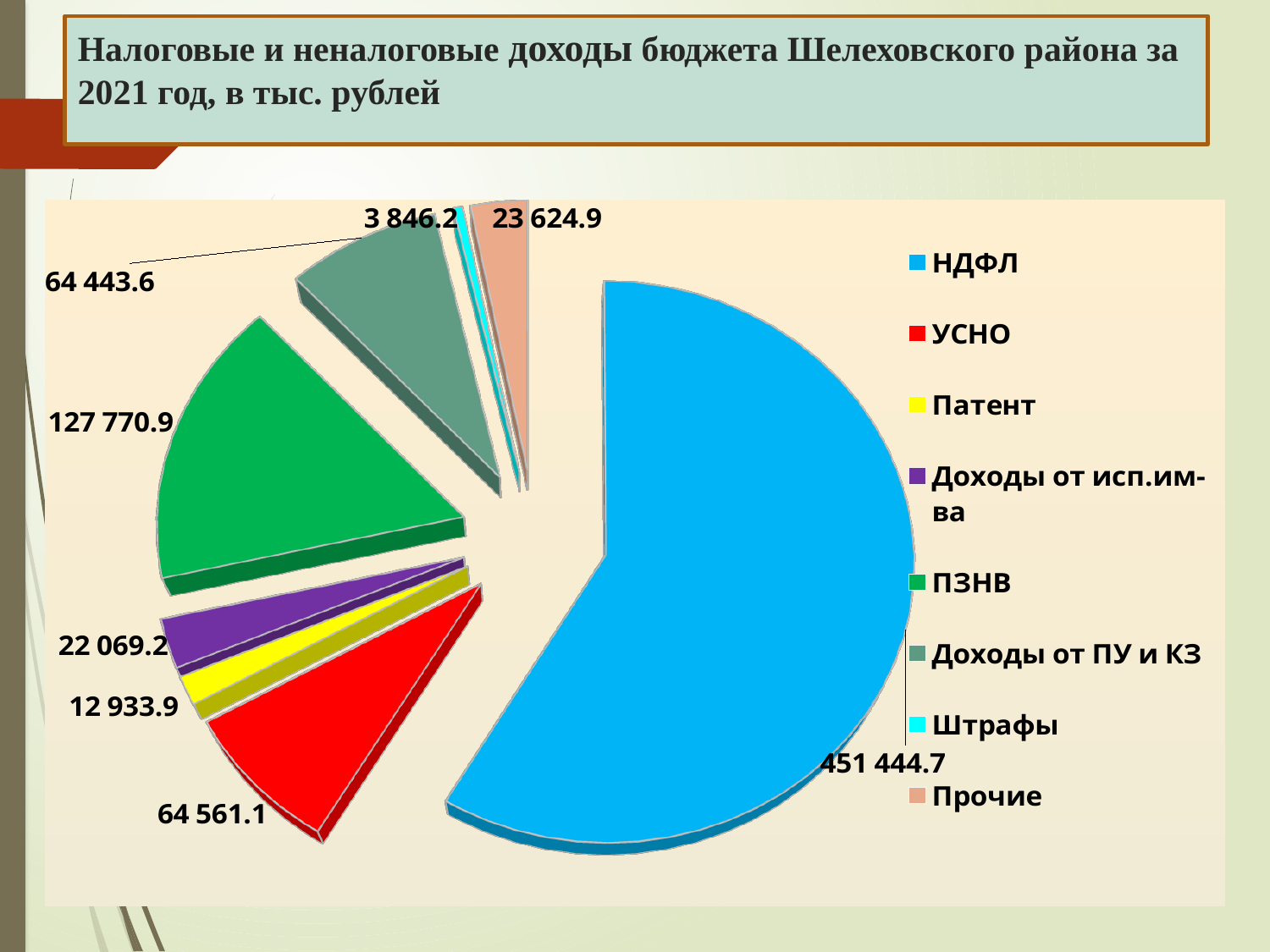
What is the value for НДФЛ? 451 444.7 What is the value for Штрафы? 3 846.2 How many entries does the legend list? 8 What kind of chart is shown on the slide? Pie chart What colour is the slice for УСНО? Red What is the value for Доходы от исп.им-ва? 22 069.2 Which category has the smallest slice? Штрафы What is the value for ПЗНВ? 127 770.9 What is the difference between the values for ПЗНВ and УСНО? 63 209.8 Which is larger, the value for Прочие or the value for Патент? Прочие Which category has the largest slice? НДФЛ How many slices does the pie chart have? 8